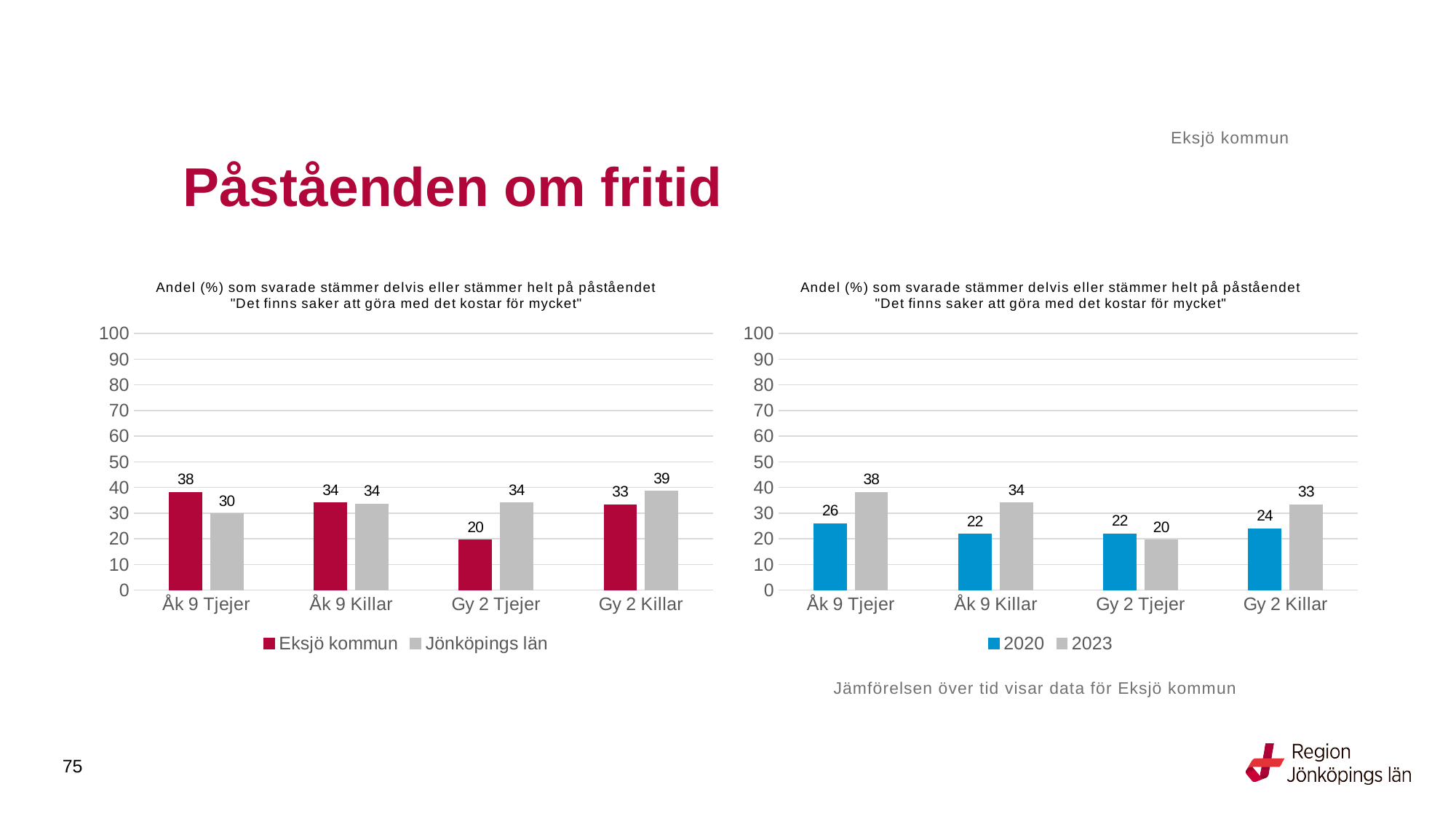
In the right chart, what is the value for 2020 for Gy 2 Killar? 24 In the right chart, what is the difference between 2023 and 2020 for Åk 9 Tjejer? 12 How many categories are shown on the x axis of the right chart? 4 In the left chart, what is the value for Eksjö kommun for Åk 9 Tjejer? 38 In the right chart, what is the value for 2023 for Åk 9 Killar? 34 In the right chart, which is larger for Gy 2 Tjejer: 2020 or 2023? 2020 In the left chart, what is the value for Jönköpings län for Gy 2 Tjejer? 34 In the left chart, how many series does the legend list? 2 In the left chart, what is the difference between Jönköpings län and Eksjö kommun for Gy 2 Killar? 6 In the left chart, which is larger for Åk 9 Tjejer: Eksjö kommun or Jönköpings län? Eksjö kommun In the right chart, which category has the highest value for 2023? Åk 9 Tjejer In the left chart, which category has the lowest value for Eksjö kommun? Gy 2 Tjejer